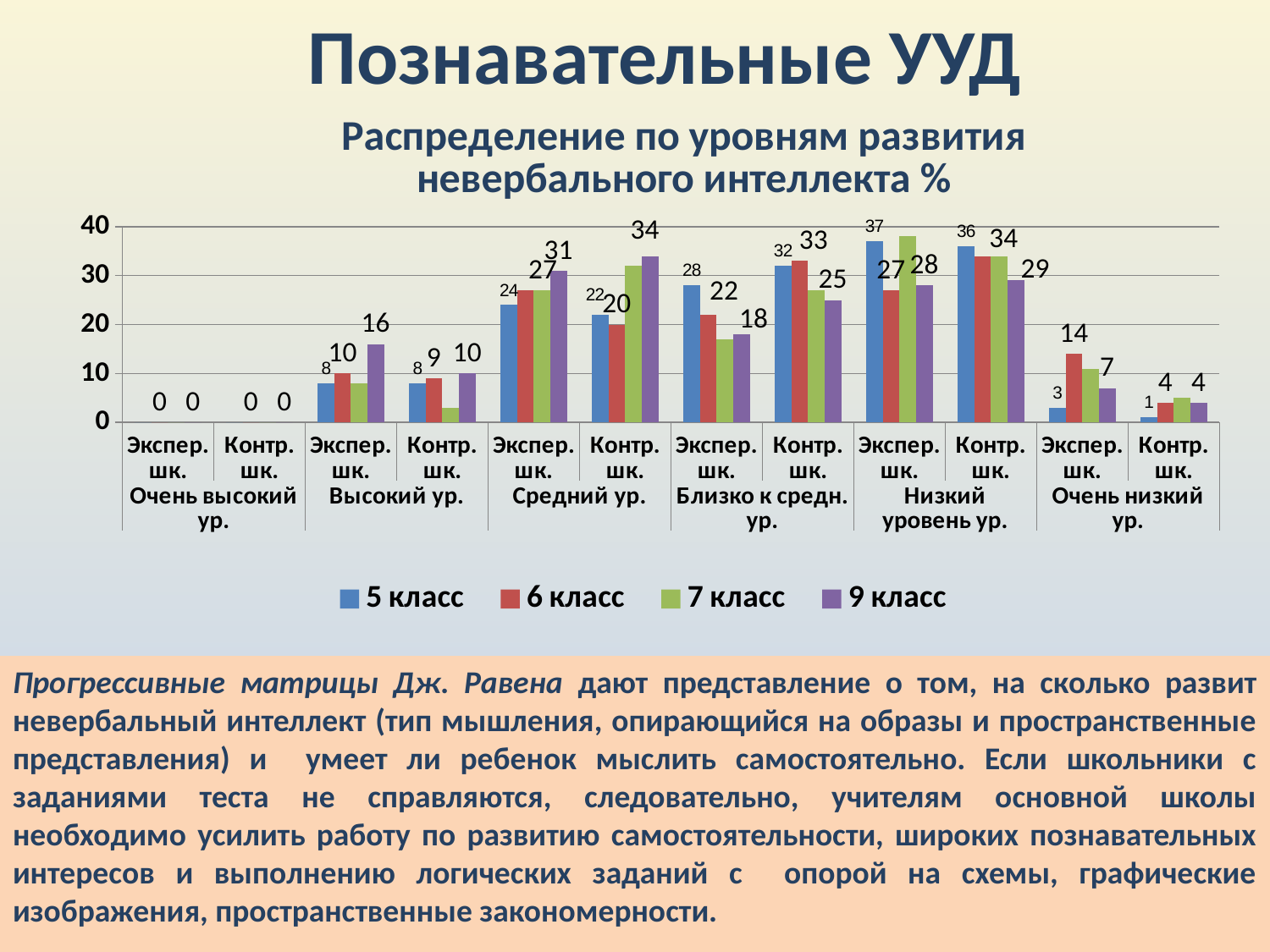
What kind of chart is shown on the slide? bar chart What is the value for 9 класс in Контр. шк. at Средний ур.? 34 What is the value for 6 класс in Контр. шк. at Близко к средн. ур.? 33 What is the value for 5 класс in Экспер. шк. at Низкий уровень ур.? 37 Is the value for 7 класс in Экспер. шк. at Низкий уровень ур. greater or less than 30? greater Which category has the highest value for 9 класс? Контр. шк. Средний ур. How many categories are shown along the x axis? 12 For 5 класс at Близко к средн. ур., which is larger: Экспер. шк. or Контр. шк.? Контр. шк. What is the difference between the 9 класс values for Экспер. шк. and Контр. шк. at Высокий ур.? 6 Is the value for 7 класс in Контр. шк. at Высокий ур. greater or less than 10? less How many series does the legend list? 4 What is the value for 6 класс in Экспер. шк. at Очень низкий ур.? 14